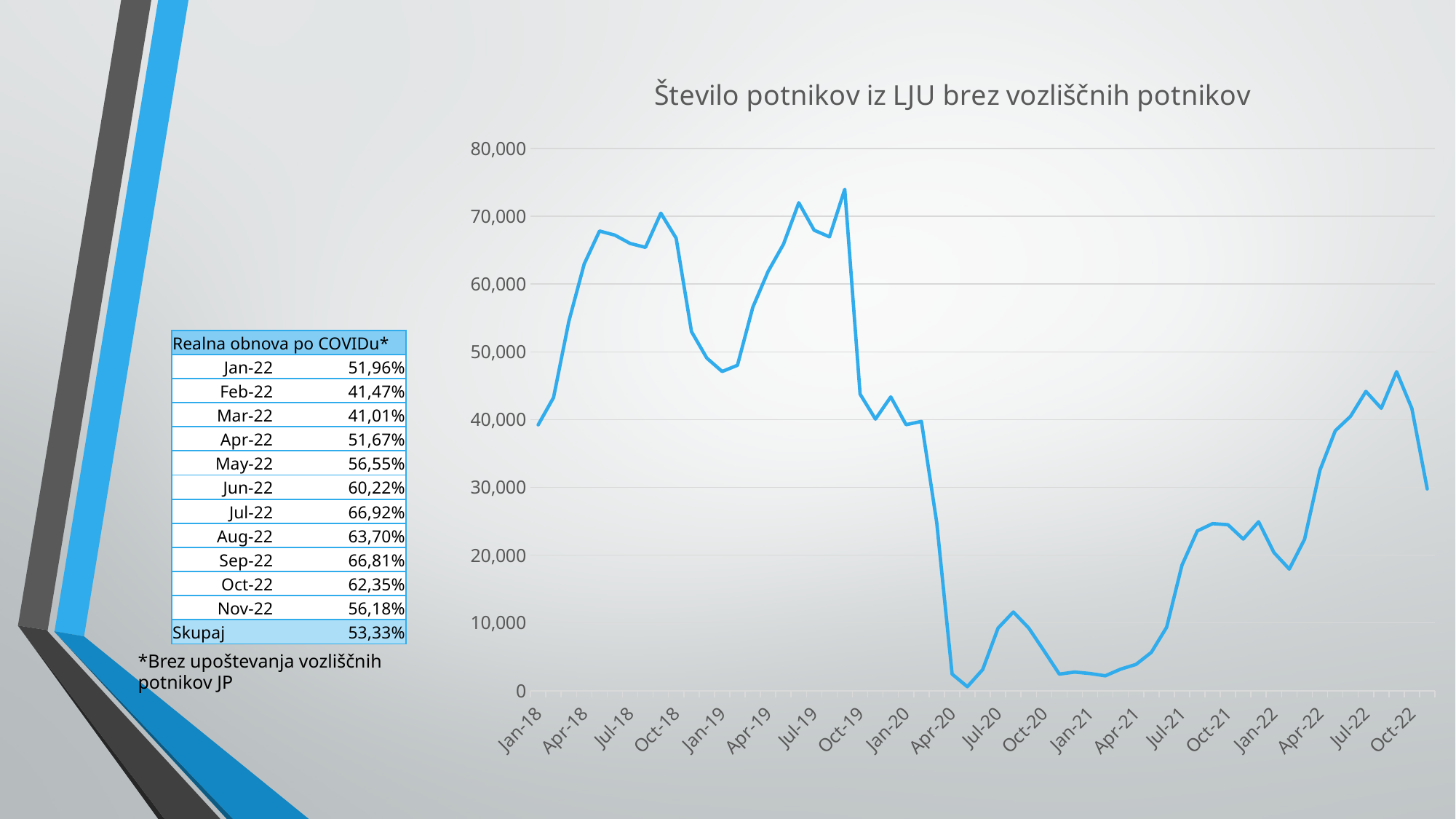
Is the value for Apr-20 greater or less than 10,000? less Is the value for Jul-22 greater or less than 40,000? greater What is the highest value shown on the chart's vertical axis? 80,000 Is the value for Oct-19 greater or less than 70,000? less Does the line rise or fall between Oct-19 and Apr-20? fall What kind of chart is shown on the slide? line chart What is the title of the chart? Število potnikov iz LJU brez vozliščnih potnikov Which is larger, the value for Apr-18 or the value for Jan-20? Apr-18